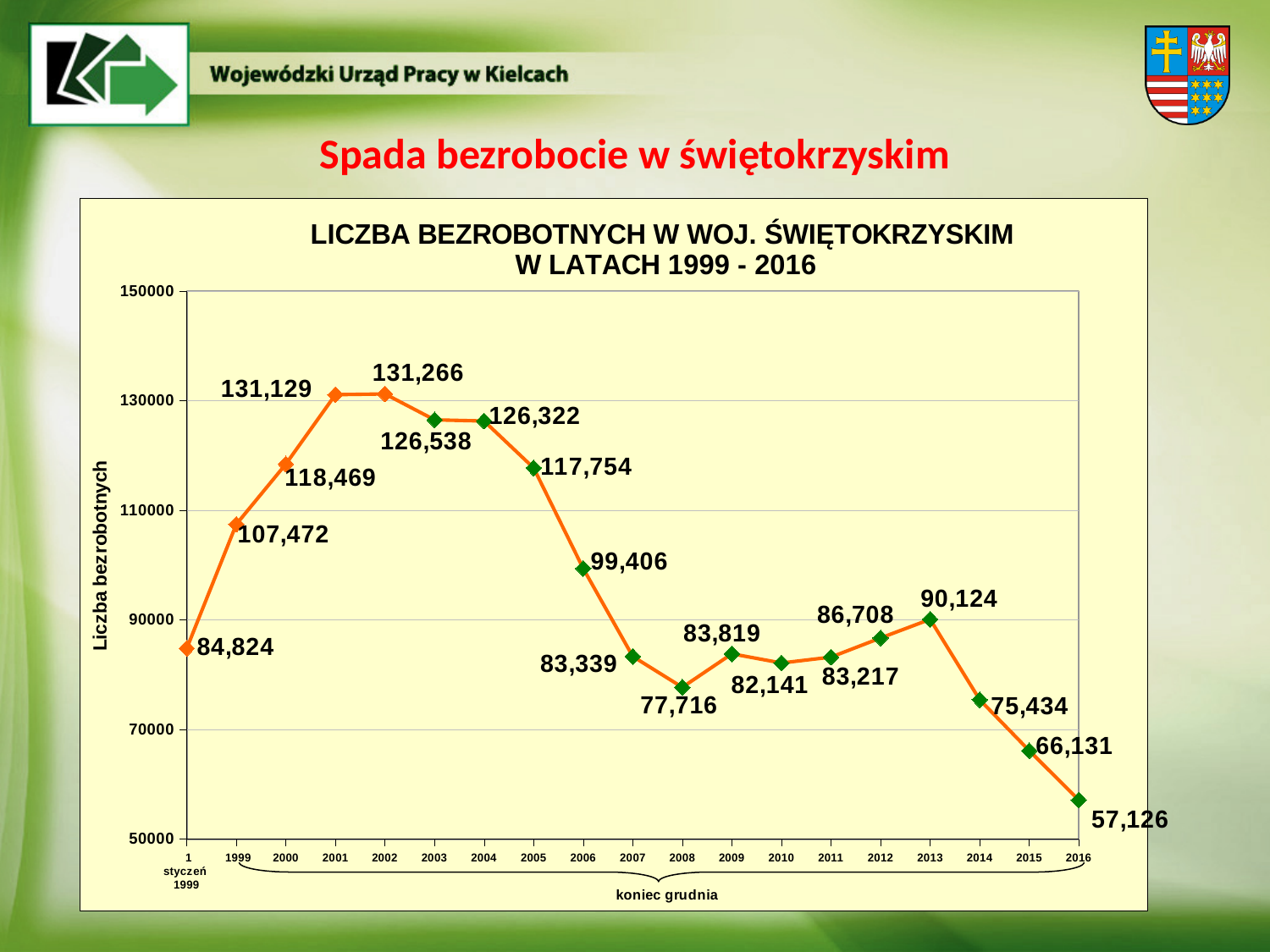
What is the value for 1 styczeń 1999? 84,824 What is the number of unemployed shown for 2016? 57,126 By how much did the value fall from 2013 to 2014? 14,690 How many data points are plotted on the chart? 19 Which year has the highest number of unemployed? 2002 Do the values rise or fall from 2013 to 2016? fall Which is larger, the value for 2006 or the value for 2012? 2006 Which year has the lowest number of unemployed? 2016 Is the value for 2005 greater or less than 110000? greater What value is plotted for 2008? 77,716 What kind of chart is shown? line chart What is the difference between the values for 2015 and 2016? 9,005